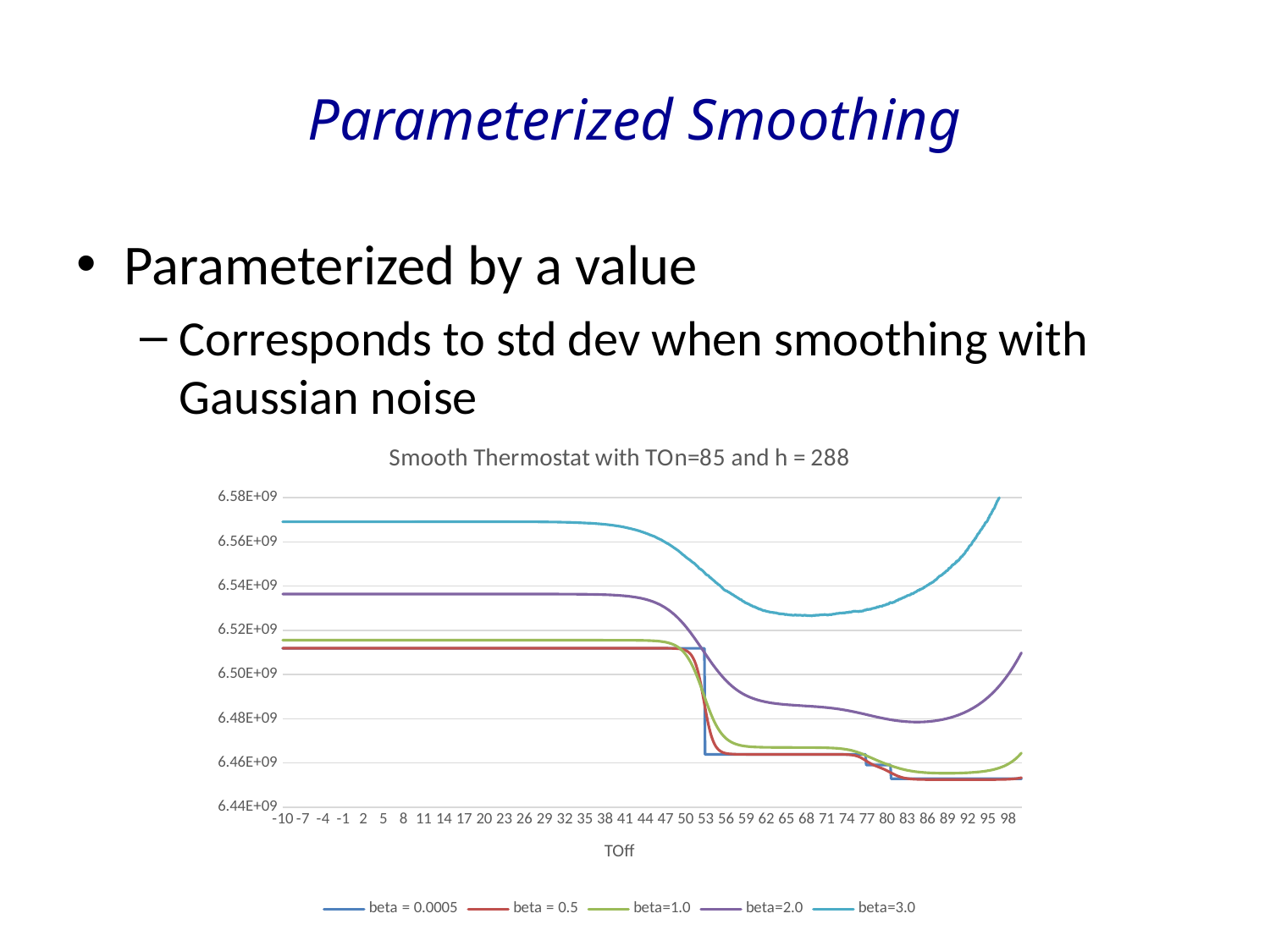
Does the beta=3.0 series rise or fall between TOff = 44 and TOff = 68? fall What is the title of the chart? Smooth Thermostat with TOn=85 and h = 288 At TOff = -10, which series has the larger value, beta=2.0 or beta=1.0? beta=2.0 What is the label on the chart's x axis? TOff Is the value for beta=1.0 at TOff = 65 greater or less than 6.48E+09? less Which series has the highest value at TOff = -10? beta=3.0 How many series does the chart's legend list? 5 Is the value for beta = 0.0005 at TOff = 2 greater or less than 6.50E+09? greater Which series has the highest value at TOff = 98? beta=3.0 What kind of chart is shown on the slide? line chart Is the value for beta=2.0 at TOff = -10 greater or less than 6.52E+09? greater